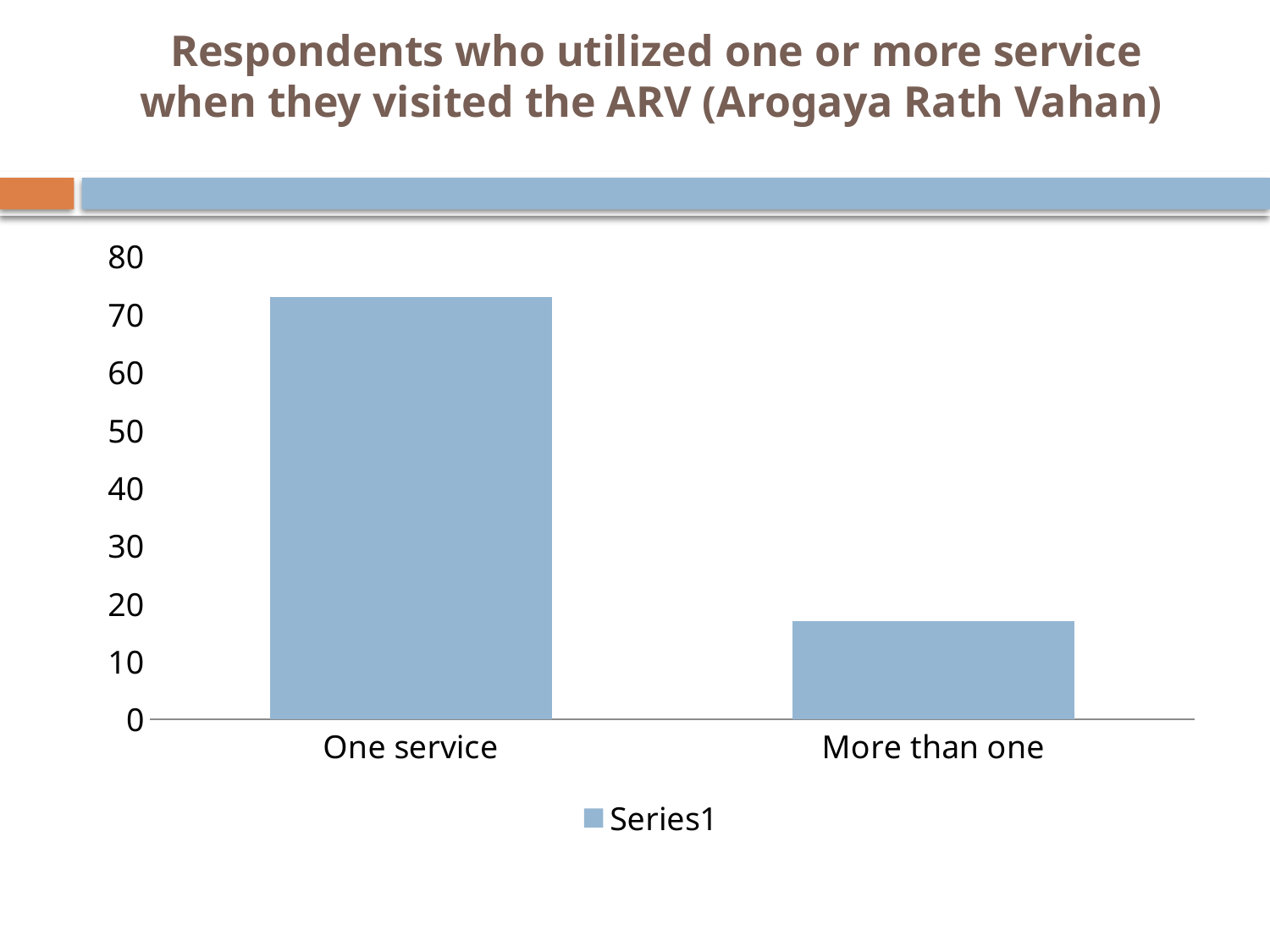
Which category has the lowest value? More than one Which is larger, the value for One service or the value for More than one? One service How many series does the legend list? 1 What is the title of the slide containing the chart? Respondents who utilized one or more service when they visited the ARV (Arogaya Rath Vahan) Is the value for One service greater or less than 70? greater What is the name of the series listed in the legend? Series1 Is the value for More than one greater or less than 10? greater How many categories are shown on the x axis of the chart? 2 Which category has the highest value? One service What kind of chart is shown on the slide? bar chart Is the value for One service greater or less than 80? less